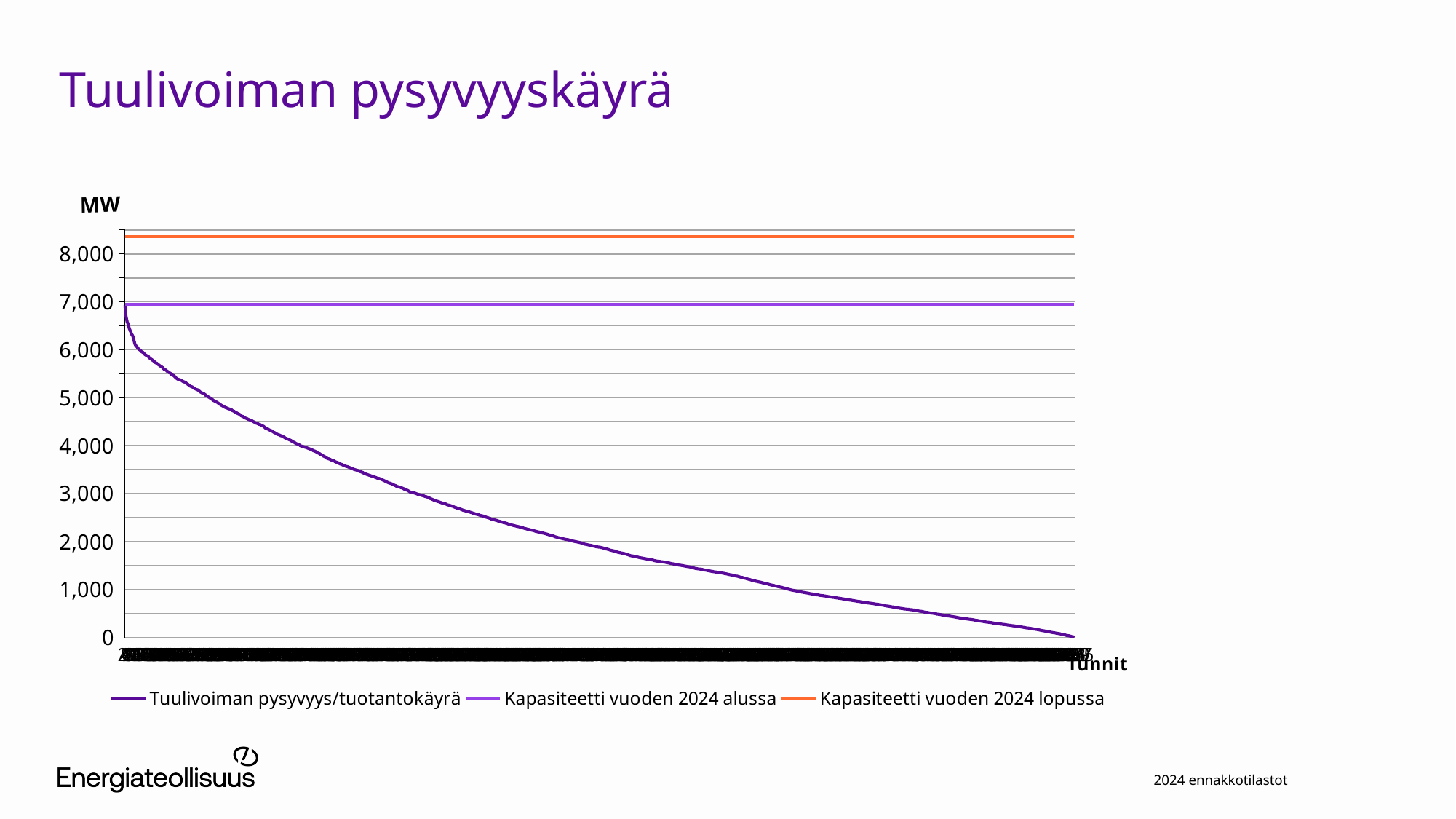
Is the value of the 'Kapasiteetti vuoden 2024 alussa' line greater or less than 6,000? greater Does the 'Tuulivoiman pysyvyys/tuotantokäyrä' line rise or fall along the x axis? fall What is the title of the chart on the slide? Tuulivoiman pysyvyyskäyrä What kind of chart is shown on the slide? line chart Is the highest value of the 'Tuulivoiman pysyvyys/tuotantokäyrä' line greater or less than 8,000? less Which line is higher on the chart: 'Kapasiteetti vuoden 2024 alussa' or 'Kapasiteetti vuoden 2024 lopussa'? Kapasiteetti vuoden 2024 lopussa Is the value of the 'Tuulivoiman pysyvyys/tuotantokäyrä' line at the right end of the x axis greater or less than 1,000? less How many series does the legend list? 3 What unit is shown on the vertical axis of the chart? MW Which series is the 'Tuulivoiman pysyvyys/tuotantokäyrä' line always below or equal to: 'Kapasiteetti vuoden 2024 lopussa' or none? Kapasiteetti vuoden 2024 lopussa